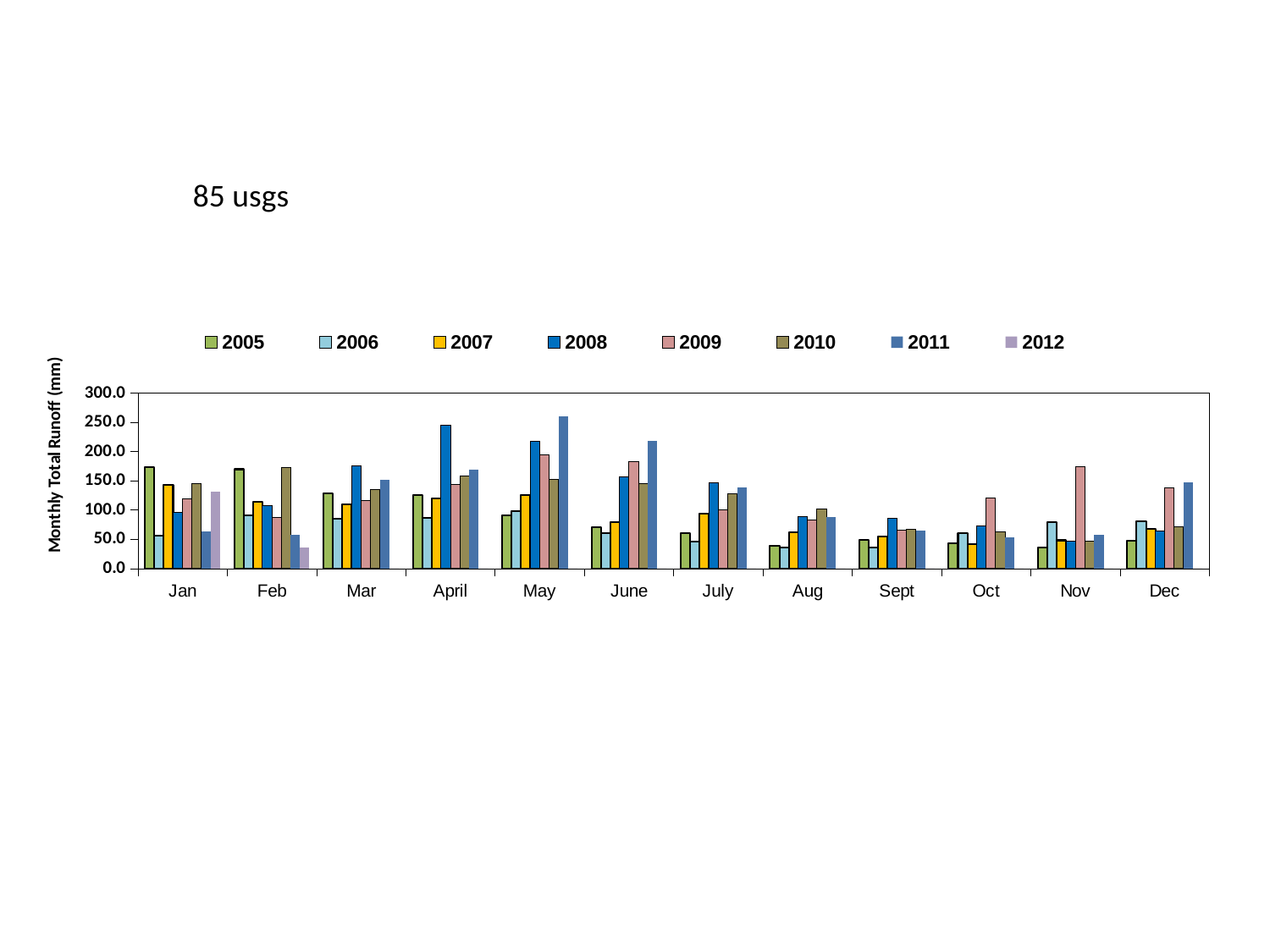
Which year has the highest value in April? 2008 Which year has the highest value in May? 2011 Is the value for 2011 in May greater or less than 200? greater Which year has the highest value in Nov? 2009 What kind of chart is shown on the slide? bar chart How many months are shown along the x axis? 12 Is the value for 2012 in Feb greater or less than 50? less How many series does the legend list? 8 In Jan, which is larger: the value for 2005 or the value for 2006? 2005 What is the label of the y axis? Monthly Total Runoff (mm) Is the value for 2009 in Oct greater or less than 100? greater